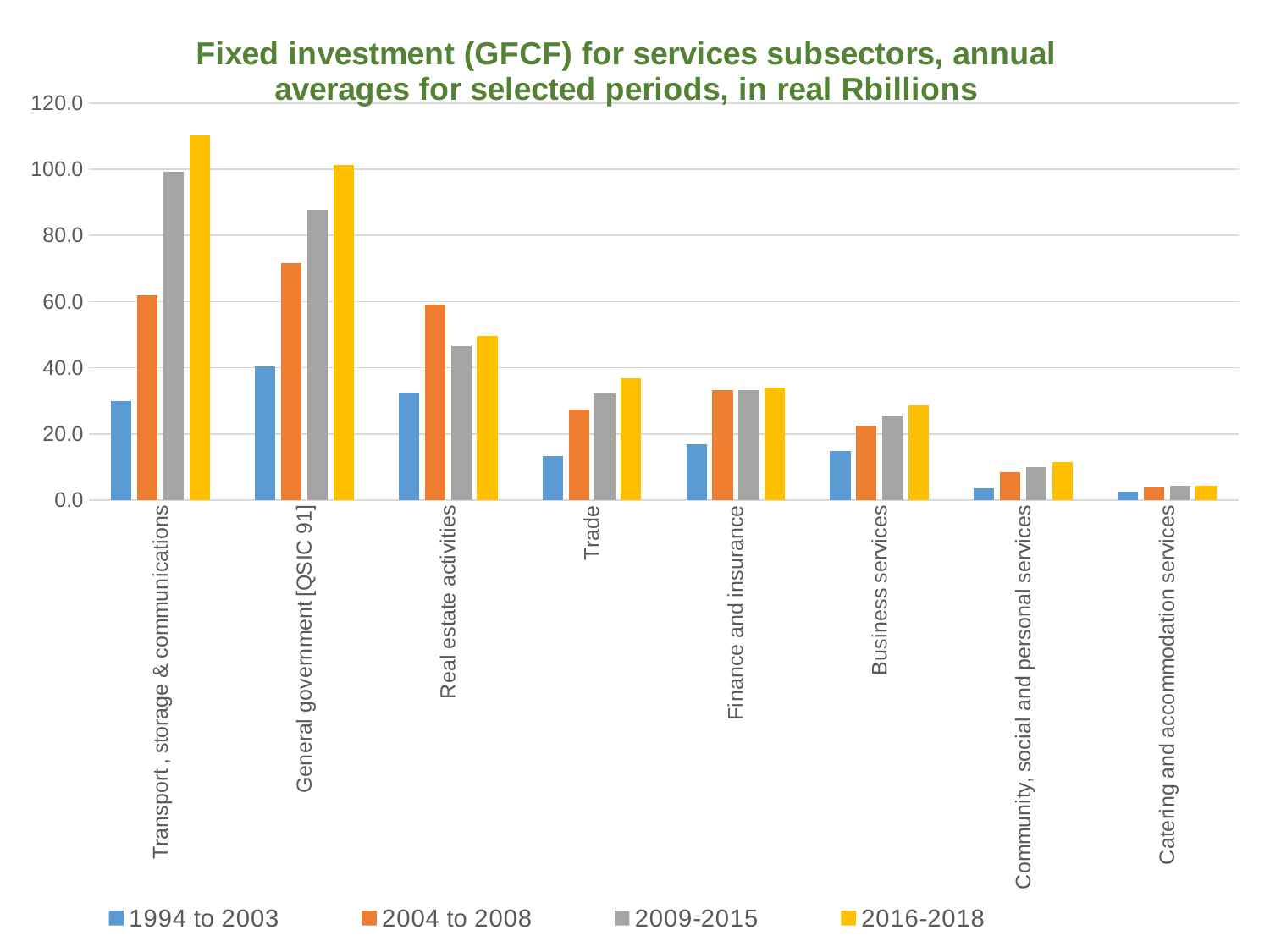
For the 2016-2018 series, do the values generally rise or fall moving from left to right across the subsectors? fall What kind of chart is shown on the slide? Bar chart Is the 1994 to 2003 value for Finance and insurance greater or less than 20? less Is the 2009-2015 value for Transport, storage & communications greater or less than 80? greater Is the 2004 to 2008 value for General government [QSIC 91] greater or less than 60? greater For the 2016-2018 series, which is larger: Business services or Community, social and personal services? Business services Which subsector has the highest value for the 2016-2018 series? Transport, storage & communications How many series does the legend list? 4 How many services subsectors (categories) are shown on the x axis? 8 For Real estate activities, which is larger: the 2004 to 2008 value or the 2009-2015 value? 2004 to 2008 Which subsector has the lowest value for the 2016-2018 series? Catering and accommodation services Which period is listed first in the legend? 1994 to 2003